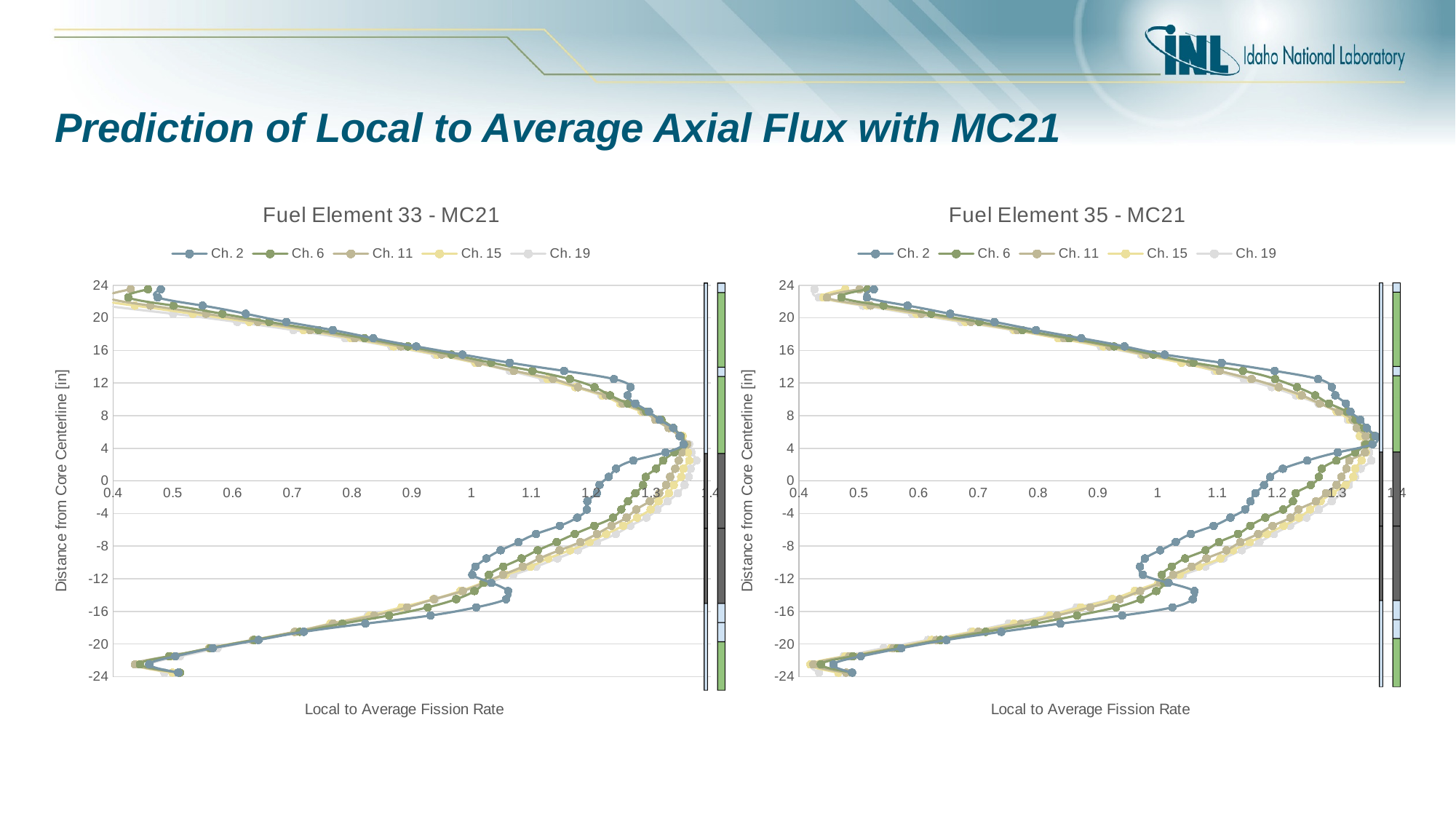
What kind of chart is "Fuel Element 33 - MC21"? line chart In "Fuel Element 33 - MC21", is the Ch. 2 value at -8 in from the core centerline greater or less than 1? greater In "Fuel Element 35 - MC21", is the Ch. 19 value at -20 in from the core centerline greater or less than 0.7? less In "Fuel Element 35 - MC21", is the Ch. 2 value at 4 in from the core centerline greater or less than 1.3? greater What is the x-axis label of the "Fuel Element 35 - MC21" chart? Local to Average Fission Rate How many series does the legend of "Fuel Element 35 - MC21" list? 5 In "Fuel Element 35 - MC21", does the Ch. 6 value rise or fall as the distance from the core centerline goes from 4 in down to -12 in? fall In "Fuel Element 33 - MC21", does the Ch. 2 value rise or fall as the distance from the core centerline goes from 24 in down to 4 in? rise In "Fuel Element 33 - MC21", which series is listed first in the legend? Ch. 2